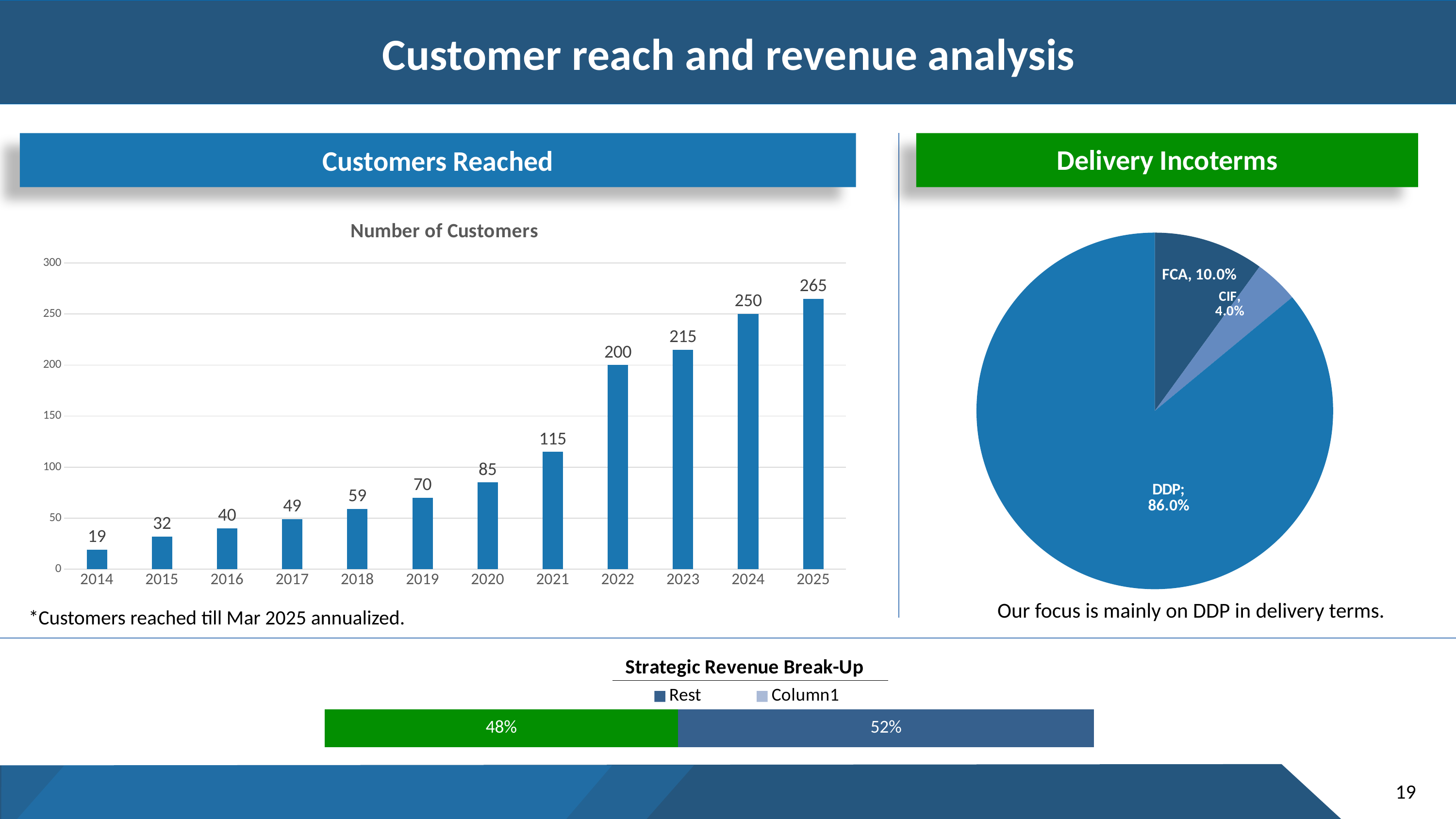
What kind of chart is the Number of Customers chart? bar chart In the Number of Customers chart, how many years are shown on the x axis? 12 In the Number of Customers chart, which is larger, the value for 2019 or the value for 2020? 2020 In the Number of Customers chart, which year has the highest number of customers? 2025 In the Number of Customers chart, do the values rise or fall from 2014 to 2025? rise In the Delivery Incoterms pie chart, which slice is the smallest? CIF In the Strategic Revenue Break-Up chart, what is the value of the green segment? 48% In the Number of Customers chart, what is the value for 2014? 19 In the Number of Customers chart, which year has the lowest number of customers? 2014 In the Delivery Incoterms pie chart, what share does DDP have? 86.0% In the Number of Customers chart, what is the difference between the values for 2025 and 2024? 15 In the Number of Customers chart, what is the value for 2021? 115